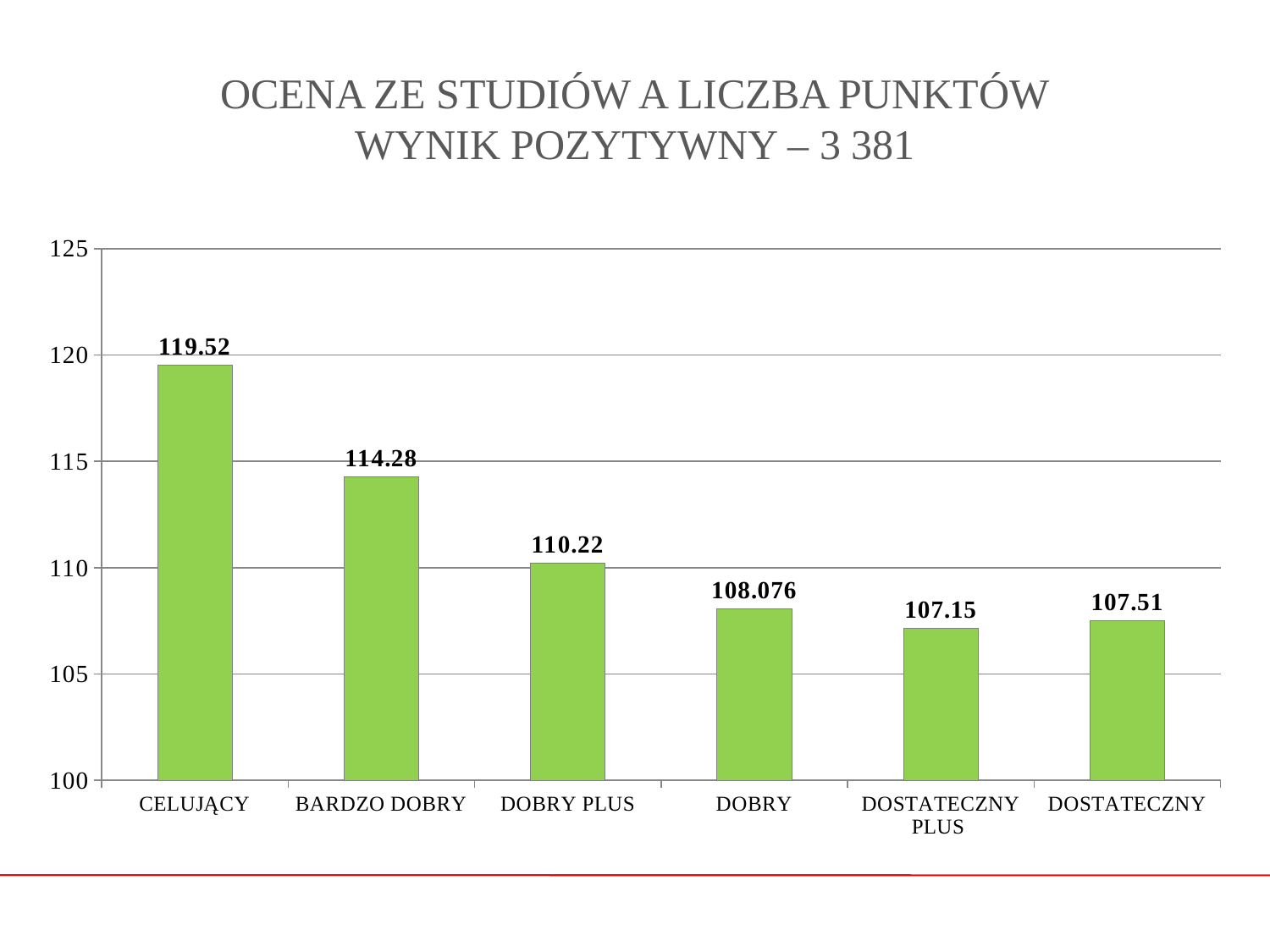
Which category has the lowest value? DOSTATECZNY PLUS What is the difference between the values for CELUJĄCY and BARDZO DOBRY? 5.24 Which category has the highest value? CELUJĄCY Which is larger, the value for BARDZO DOBRY or the value for DOBRY PLUS? BARDZO DOBRY What kind of chart is shown on the slide? bar chart How many categories are shown on the x axis? 6 What is the title of the chart? OCENA ZE STUDIÓW A LICZBA PUNKTÓW WYNIK POZYTYWNY – 3 381 What is the value for DOBRY? 108.076 What is the value for DOSTATECZNY PLUS? 107.15 What is the difference between the values for DOSTATECZNY and DOSTATECZNY PLUS? 0.36 Is the value for DOBRY PLUS greater or less than 110? greater What is the value for CELUJĄCY? 119.52